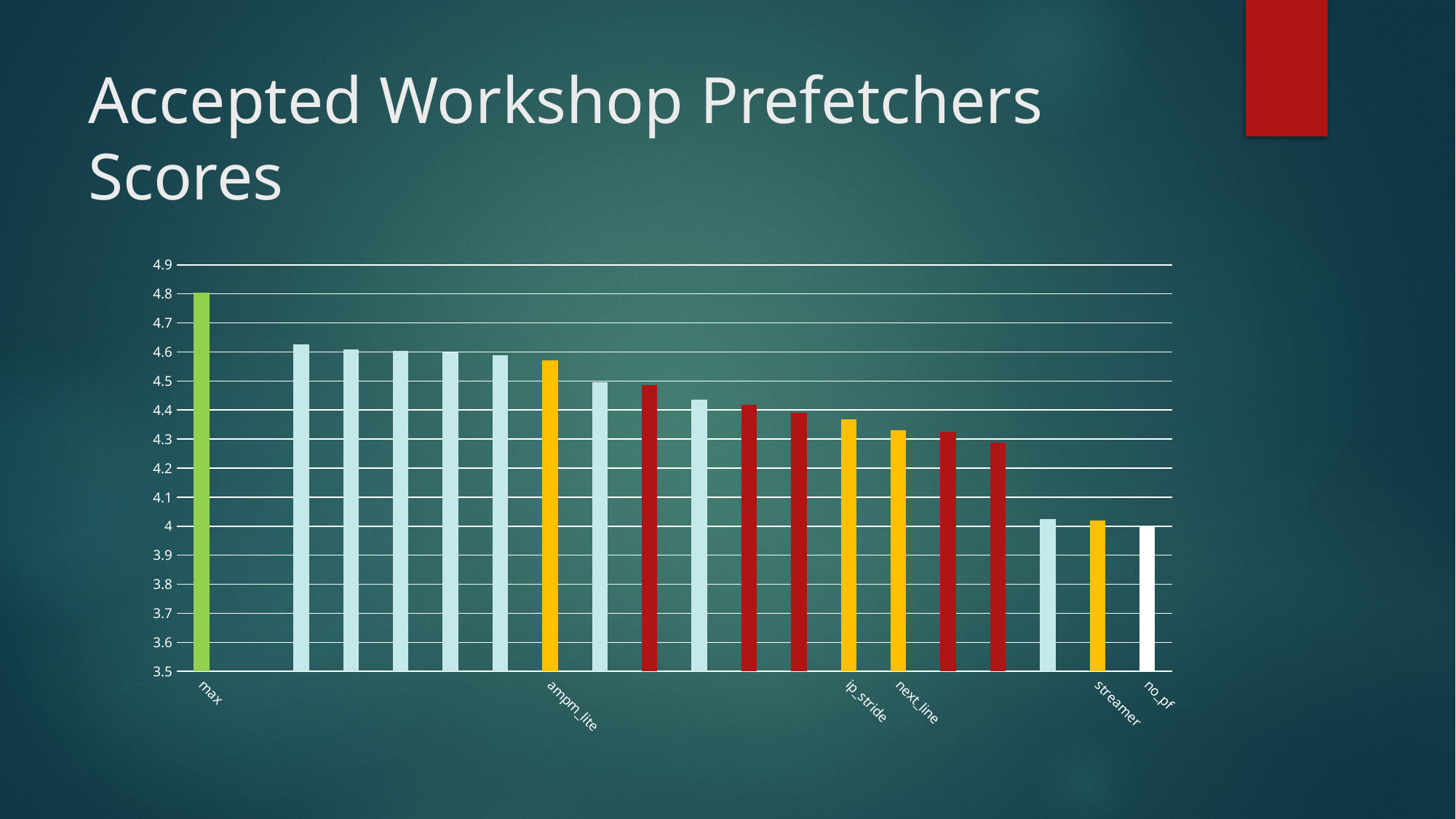
Which category has the lowest bar? no_pf Which category has the highest bar? max Is the value for max greater or less than 4.7? greater What is the title of the slide containing the chart? Accepted Workshop Prefetchers Scores Do the bar values rise or fall from left to right along the x axis? fall Is the value for ip_stride greater or less than 4.4? less Is the value for streamer greater or less than 4.1? less Which has the larger value, next_line or streamer? next_line What kind of chart is shown on the slide? bar chart Which has the larger value, ampm_lite or ip_stride? ampm_lite